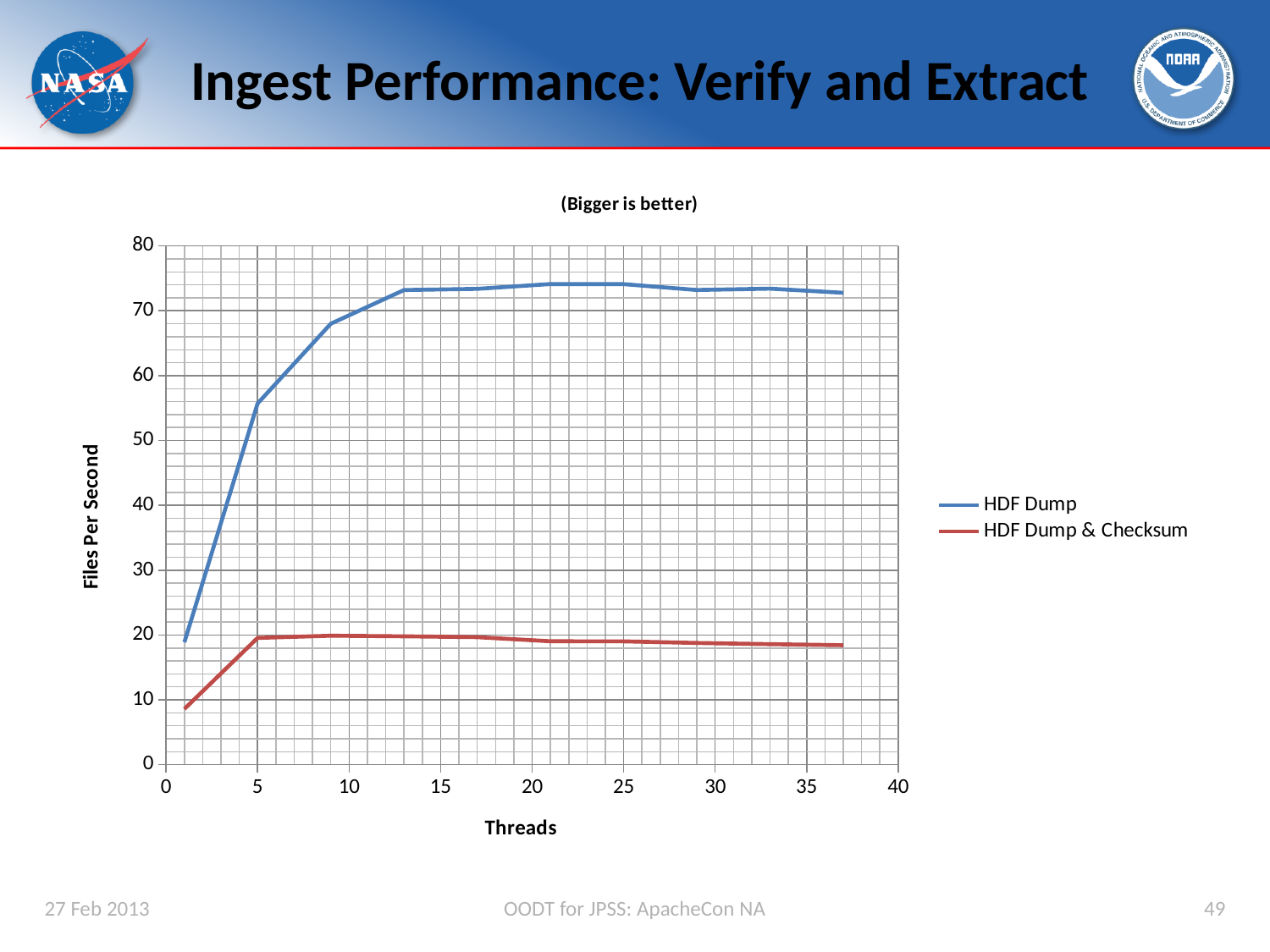
Is the value for HDF Dump at 20 threads greater or less than 70? greater How many series does the legend list? 2 Is the value for HDF Dump at 5 threads greater or less than 50? greater Is the value for HDF Dump & Checksum at 1 thread greater or less than 10? less What are the two series named in the legend? HDF Dump and HDF Dump & Checksum What is the label of the y axis? Files Per Second Does the HDF Dump series rise or fall as threads increase from 1 to 10? rise Which series reaches the highest files per second on the chart? HDF Dump At 20 threads, which series has the larger value, HDF Dump or HDF Dump & Checksum? HDF Dump What kind of chart is shown on the slide? line chart